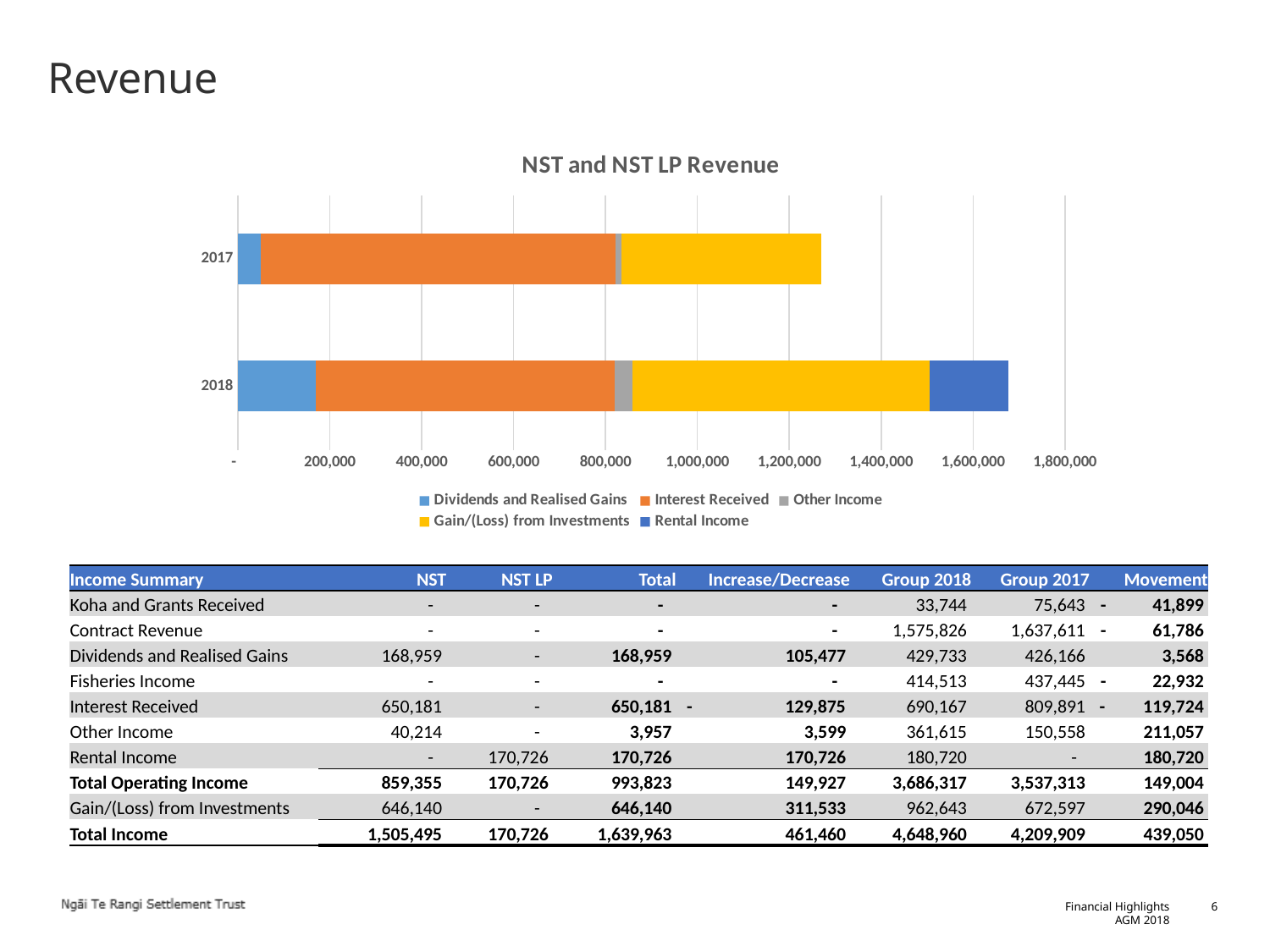
Which year has the longer total bar in the chart, 2017 or 2018? 2018 Which series appears in the 2018 bar but not in the 2017 bar? Rental Income Is the total bar length for 2017 greater or less than 1,200,000? greater How many years (categories) are plotted in the chart? 2 How many series does the chart legend list? 5 Is the Interest Received segment larger in 2017 or in 2018? 2017 What type of chart is shown on the slide? bar chart Is the total bar length for 2017 greater or less than 1,400,000? less Does total revenue rise or fall from 2017 to 2018 in the chart? rise Is the total bar length for 2018 greater or less than 1,400,000? greater Is the Gain/(Loss) from Investments segment larger in 2017 or in 2018? 2018 What is the title of the chart? NST and NST LP Revenue